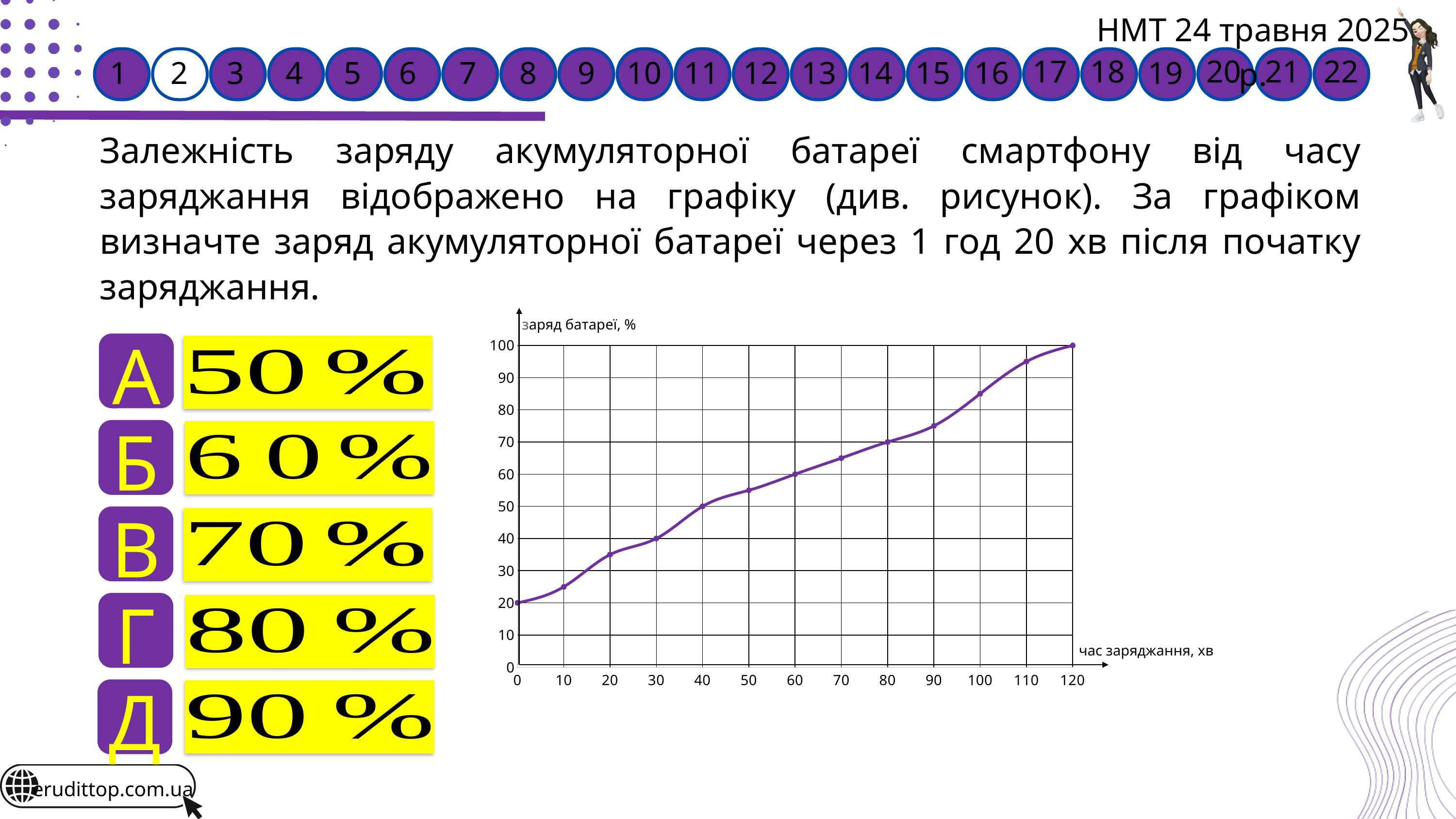
What is the battery charge at 120 minutes of charging? 100 What is the battery charge at 40 minutes of charging? 50 What is the label of the vertical axis? заряд батареї, % What is the battery charge at 80 minutes of charging? 70 Does the battery charge rise or fall as charging time increases? rises What is the battery charge at 60 minutes of charging? 60 How many data points are marked on the line? 13 Is the battery charge at 100 minutes greater or less than 80? greater What is the battery charge at 0 minutes of charging? 20 What kind of chart is shown on the slide? line chart By how much does the battery charge increase between 0 and 120 minutes? 80 Is the battery charge at 20 minutes greater or less than 30? greater